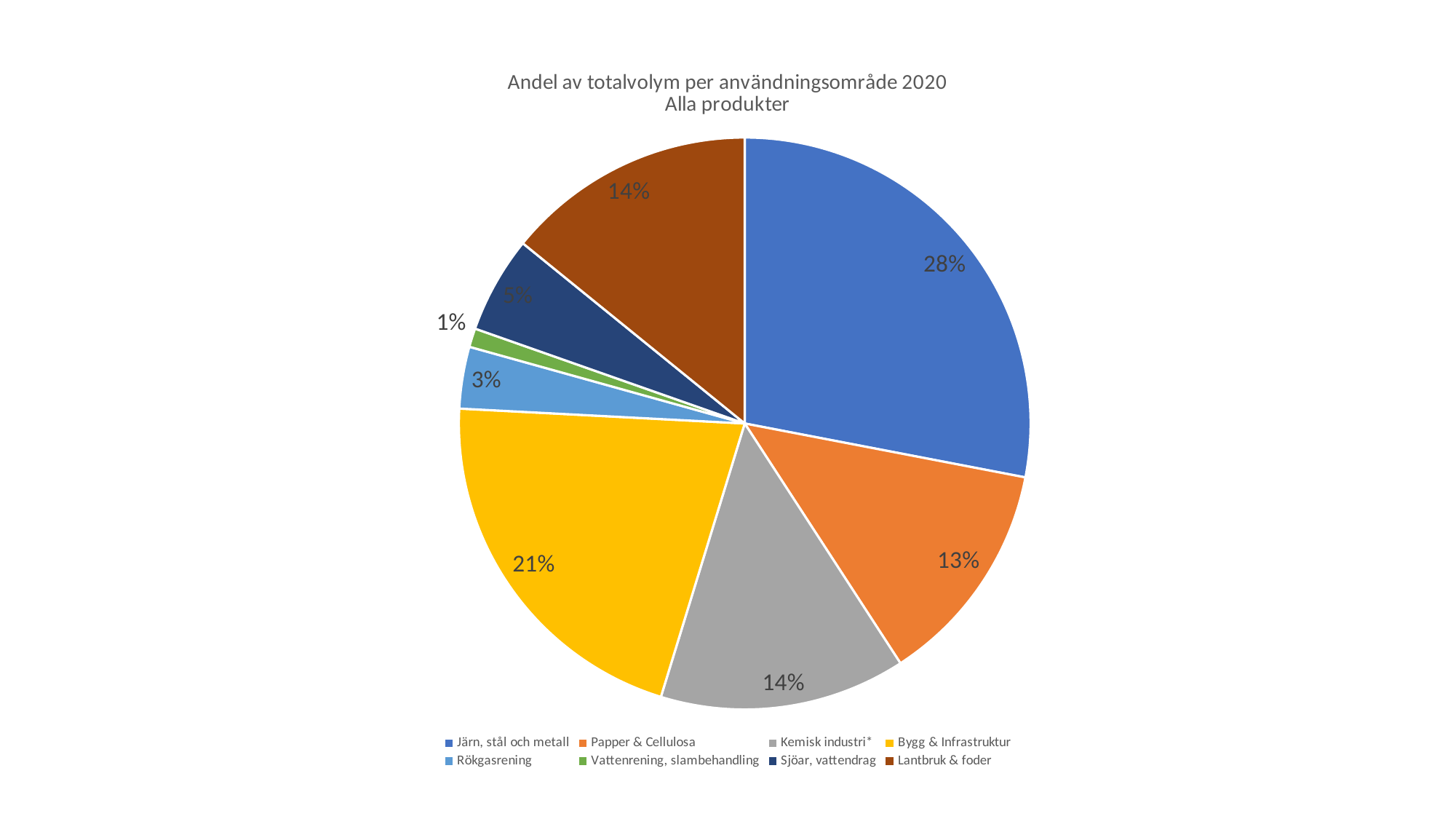
What type of chart is shown on the slide? Pie chart What is the title of the chart? Andel av totalvolym per användningsområde 2020 Alla produkter Which is larger, the share for Papper & Cellulosa or the share for Sjöar, vattendrag? Papper & Cellulosa What percentage is shown for Bygg & Infrastruktur? 21% Which category has the largest share of the pie? Järn, stål och metall What share of the total volume does Järn, stål och metall account for? 28% How many categories are shown in the pie chart? 8 Which category has the smallest share of the pie? Vattenrening, slambehandling What is the difference in percentage points between Järn, stål och metall and Bygg & Infrastruktur? 7 What share is shown for Sjöar, vattendrag? 5% What percentage does Rökgasrening represent? 3% What is the value for Papper & Cellulosa? 13%